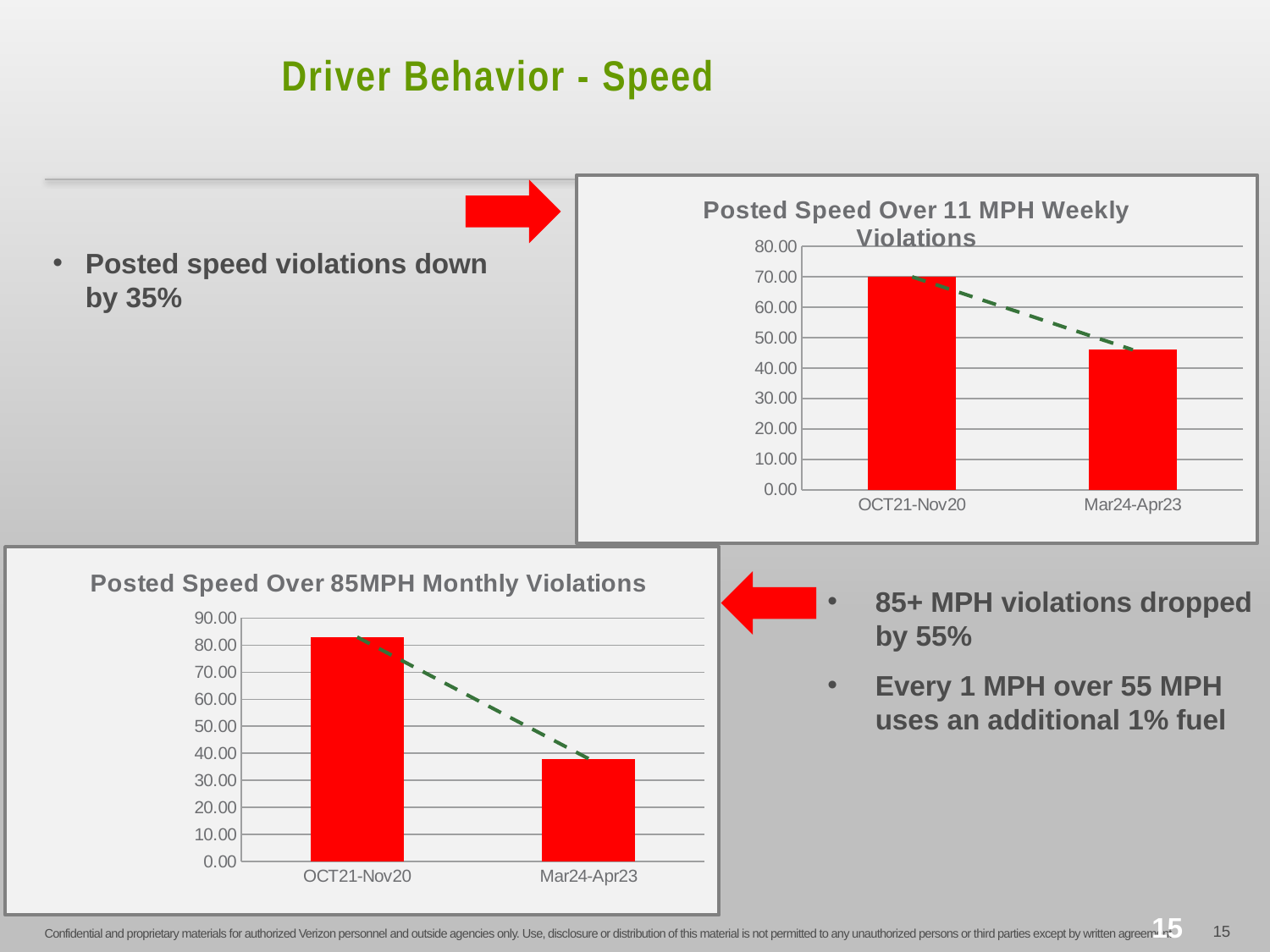
In the 'Posted Speed Over 11 MPH Weekly Violations' chart, how many categories are plotted? 2 In the 'Posted Speed Over 11 MPH Weekly Violations' chart, what kind of chart is shown? bar chart In the 'Posted Speed Over 85MPH Monthly Violations' chart, what is the highest value shown on the vertical axis? 90.00 In the 'Posted Speed Over 11 MPH Weekly Violations' chart, is the value for OCT21-Nov20 greater or less than 60.00? greater In the 'Posted Speed Over 85MPH Monthly Violations' chart, what kind of chart is shown? bar chart In the 'Posted Speed Over 85MPH Monthly Violations' chart, which category has the lower value? Mar24-Apr23 In the 'Posted Speed Over 85MPH Monthly Violations' chart, what colour are the bars? red In the 'Posted Speed Over 85MPH Monthly Violations' chart, is the value for OCT21-Nov20 greater or less than 80.00? greater In the 'Posted Speed Over 11 MPH Weekly Violations' chart, which category has the higher value? OCT21-Nov20 In the 'Posted Speed Over 85MPH Monthly Violations' chart, is the value for Mar24-Apr23 greater or less than 40.00? less In the 'Posted Speed Over 11 MPH Weekly Violations' chart, do the values rise or fall from OCT21-Nov20 to Mar24-Apr23? fall